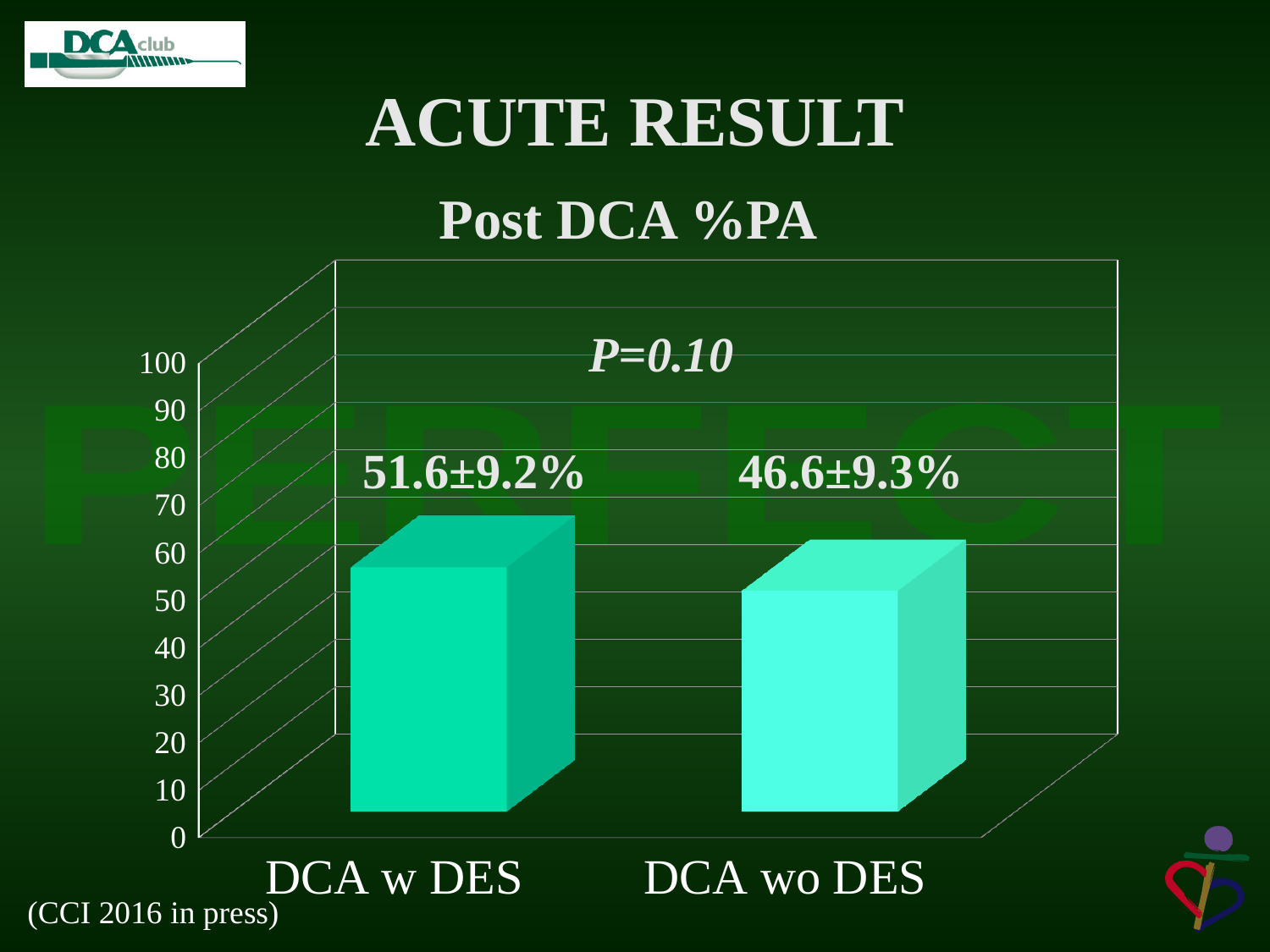
What kind of chart is shown on the slide? bar chart What is the difference between the mean values for DCA w DES and DCA wo DES? 5.0% Which category has the lower Post DCA %PA value? DCA wo DES What is the value shown for DCA w DES? 51.6±9.2% What is the title of the chart? Post DCA %PA Is the value for DCA w DES greater or less than 40? greater Is the value for DCA wo DES greater or less than 60? less What P value is printed on the chart? P=0.10 What is the value shown for DCA wo DES? 46.6±9.3% Is the value for DCA w DES larger or smaller than the value for DCA wo DES? larger Which category has the higher Post DCA %PA value? DCA w DES How many categories are shown on the chart? 2